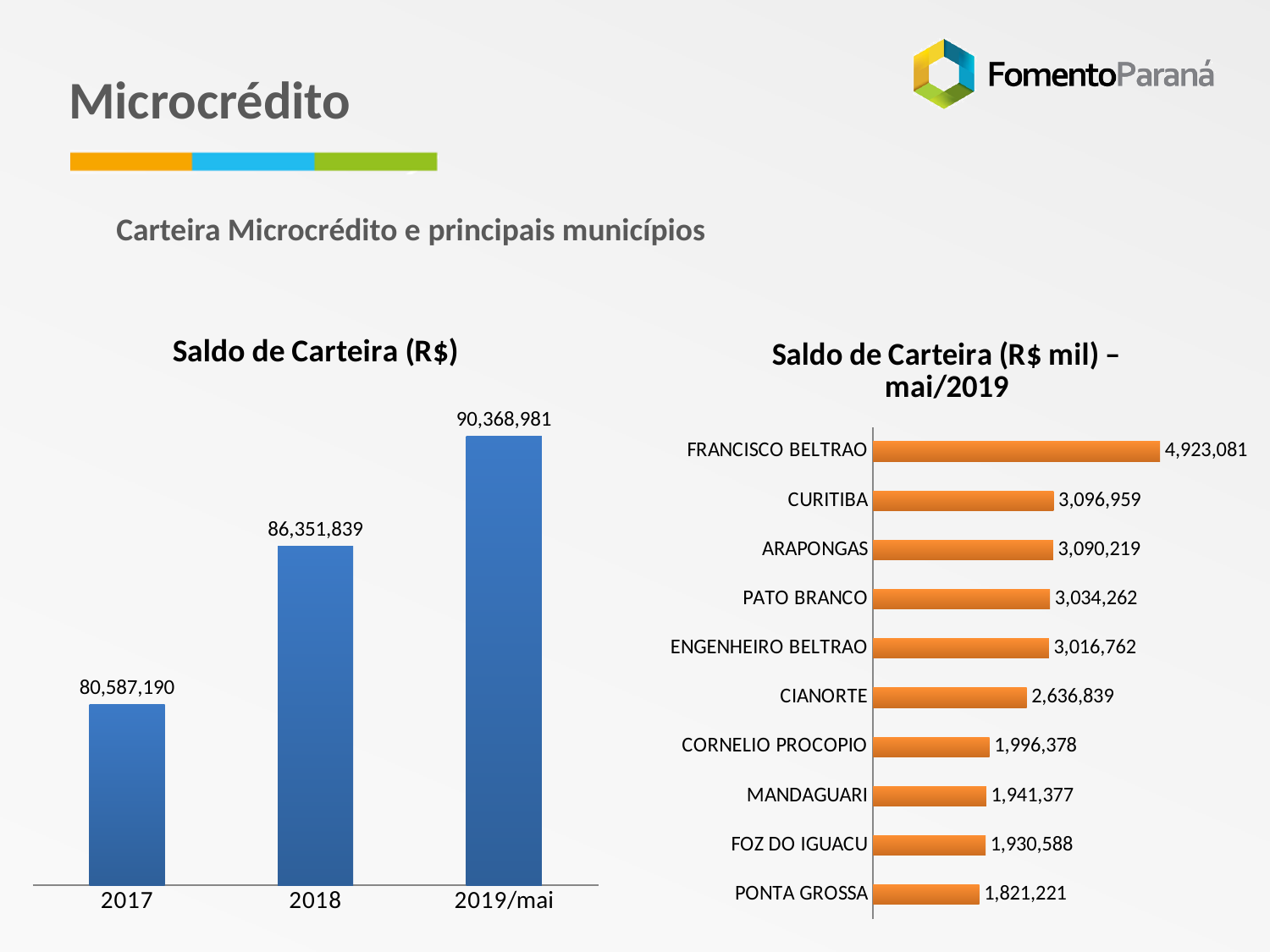
In the 'Saldo de Carteira (R$)' chart, what is the difference between the 2019/mai value and the 2017 value? 9,781,791 In the 'Saldo de Carteira (R$ mil) – mai/2019' chart, how many municipalities are listed? 10 In the 'Saldo de Carteira (R$)' chart, what is the value for 2018? 86,351,839 In the 'Saldo de Carteira (R$)' chart, what is the value for 2019/mai? 90,368,981 In the 'Saldo de Carteira (R$ mil) – mai/2019' chart, which municipality has the lowest value? PONTA GROSSA In the 'Saldo de Carteira (R$ mil) – mai/2019' chart, what is the difference between FRANCISCO BELTRAO and CURITIBA? 1,826,122 In the 'Saldo de Carteira (R$)' chart, do the values rise or fall from 2017 to 2019/mai? rise In the 'Saldo de Carteira (R$ mil) – mai/2019' chart, which municipality has the highest value? FRANCISCO BELTRAO In the 'Saldo de Carteira (R$)' chart, how many bars are plotted? 3 In the 'Saldo de Carteira (R$ mil) – mai/2019' chart, what is the value for CIANORTE? 2,636,839 In the 'Saldo de Carteira (R$ mil) – mai/2019' chart, what is the value for CURITIBA? 3,096,959 In the 'Saldo de Carteira (R$)' chart, which year has the lowest value? 2017